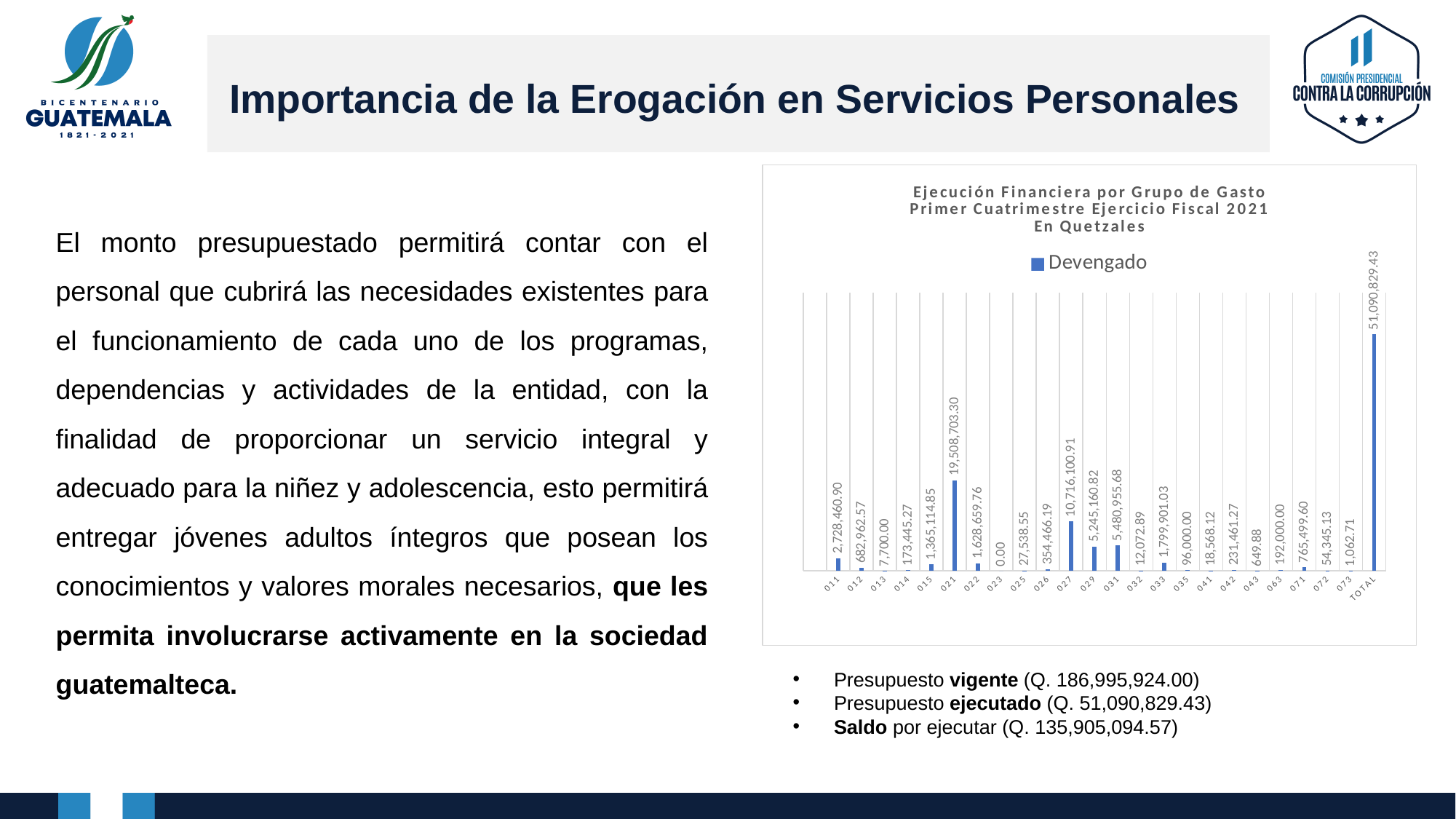
What is the name of the series shown in the legend? Devengado How many bars are plotted in the chart, including the TOTAL bar? 24 Which expense group has the lowest Devengado value? 023 What is the value shown for the TOTAL bar? 51,090,829.43 What type of chart is shown on the slide? bar chart What is the Devengado value for group 023? 0.00 Which has a larger Devengado value, group 011 or group 015? 011 What is the difference between the Devengado values for groups 021 and 027? 8,792,602.39 What is the Devengado value for group 027? 10,716,100.91 How many series does the legend list? 1 Excluding the TOTAL bar, which expense group has the highest Devengado value? 021 What is the Devengado value for group 021? 19,508,703.30